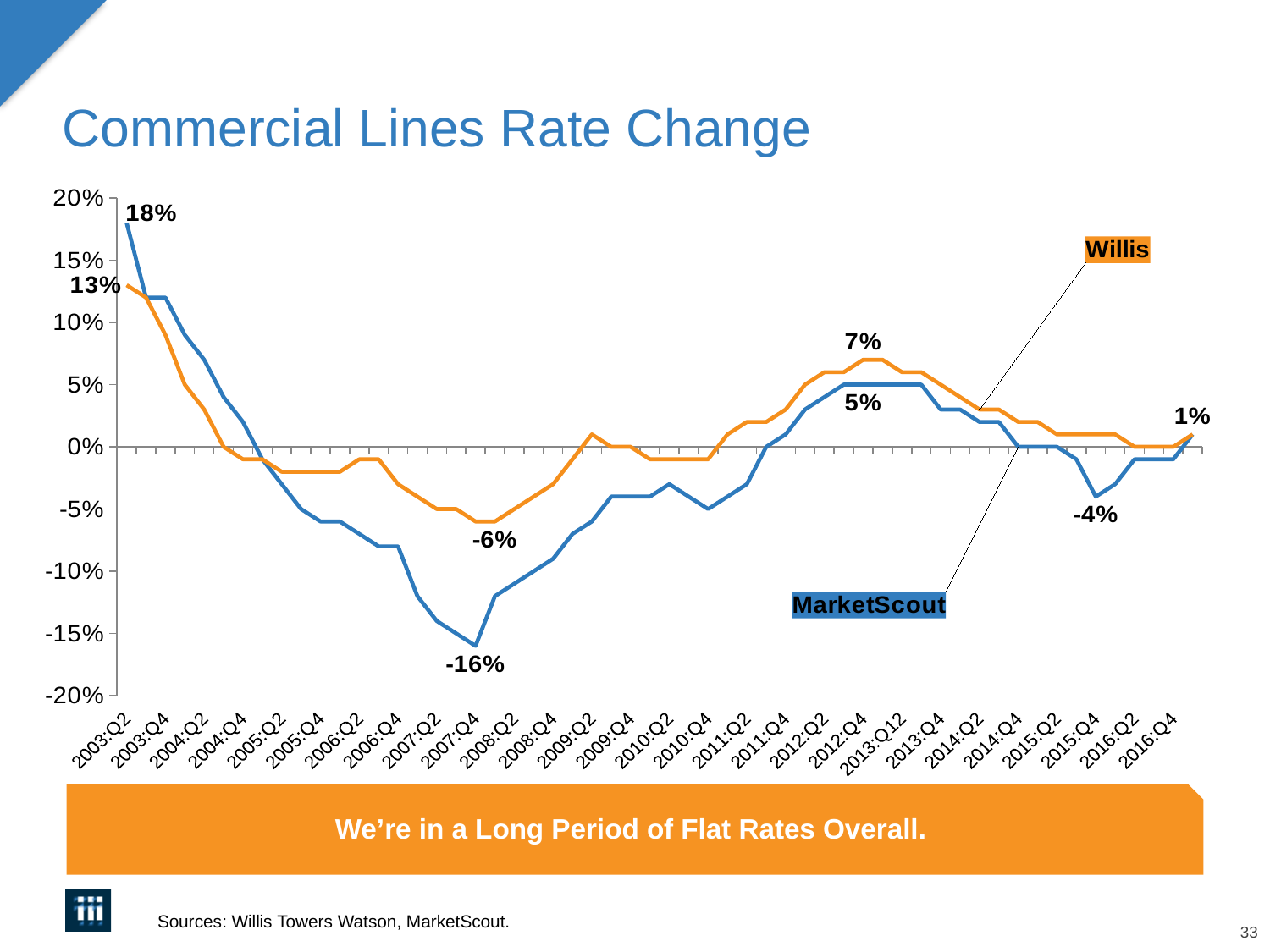
What is the labeled value of the MarketScout line around 2012:Q4? 5% What kind of chart is shown on the slide? line chart What is the labeled Willis rate change at the start of the chart (2003:Q2)? 13% What is the labeled peak value of the Willis line around 2012:Q4? 7% What is the labeled MarketScout rate change at the start of the chart (2003:Q2)? 18% At the start of the chart, which series shows the higher rate change, Willis or MarketScout? MarketScout By how many percentage points does the MarketScout starting value (18%) exceed the Willis starting value (13%)? 5 percentage points How many data series are plotted on the chart? 2 What is the labeled value at the end of the chart (2016:Q4)? 1% What is the lowest labeled value on the MarketScout line? -16% Is the Willis value at 2009:Q2 greater or less than 5%? less What colour is the Willis line? orange